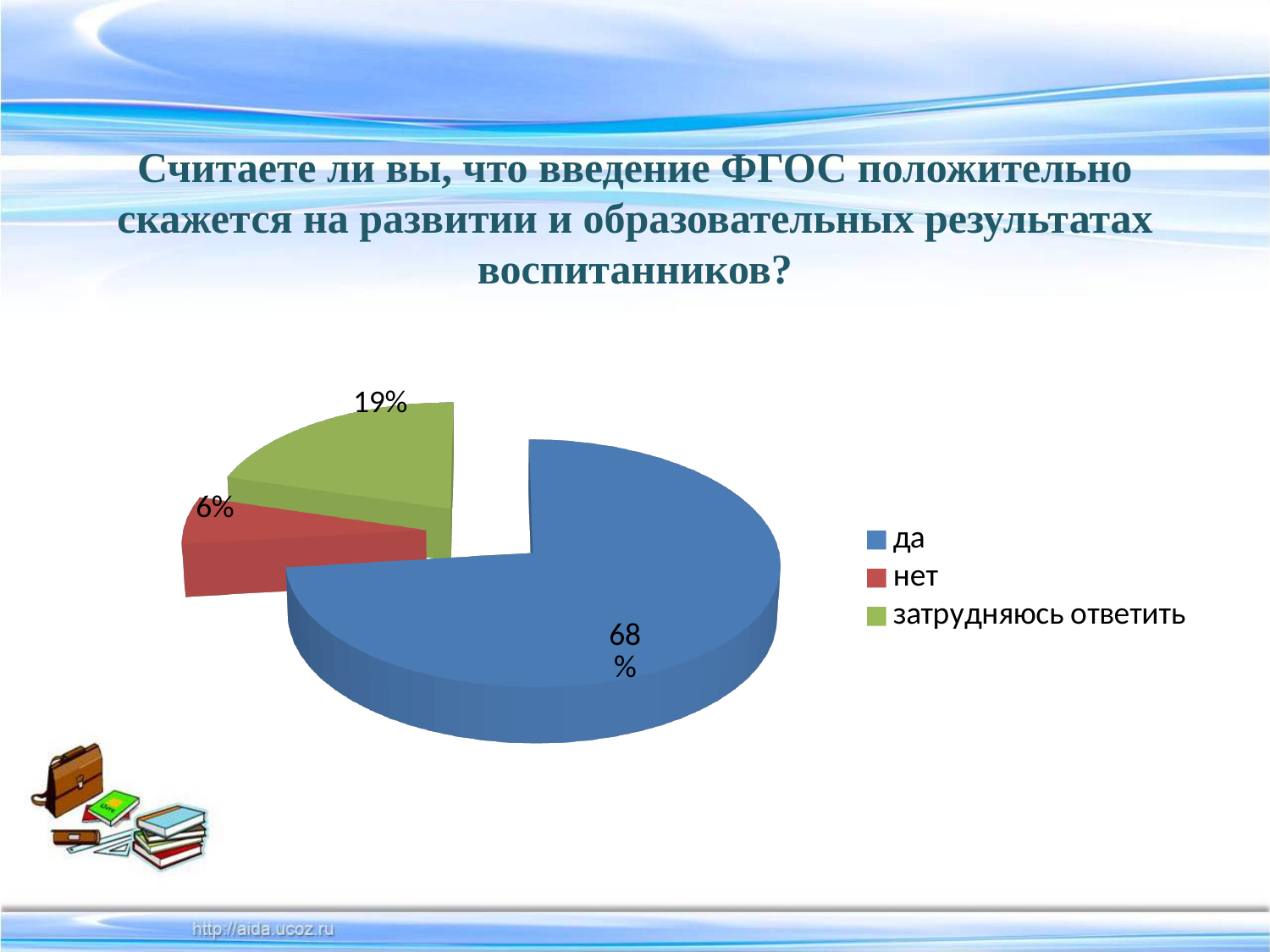
What share of the pie does the "нет" slice represent? 6% What is the difference in percentage points between the "да" slice and the "затрудняюсь ответить" slice? 49 Which is larger, the "нет" slice or the "затрудняюсь ответить" slice? затрудняюсь ответить What is the difference in percentage points between the "затрудняюсь ответить" slice and the "нет" slice? 13 How many entries does the legend list? 3 What share of the pie does the "затрудняюсь ответить" slice represent? 19% What share of the pie does the "да" slice represent? 68% Which category has the largest slice of the pie? да What colour is the "затрудняюсь ответить" slice? green How many categories does the pie chart show? 3 Which category has the smallest slice of the pie? нет What kind of chart is shown on the slide? pie chart